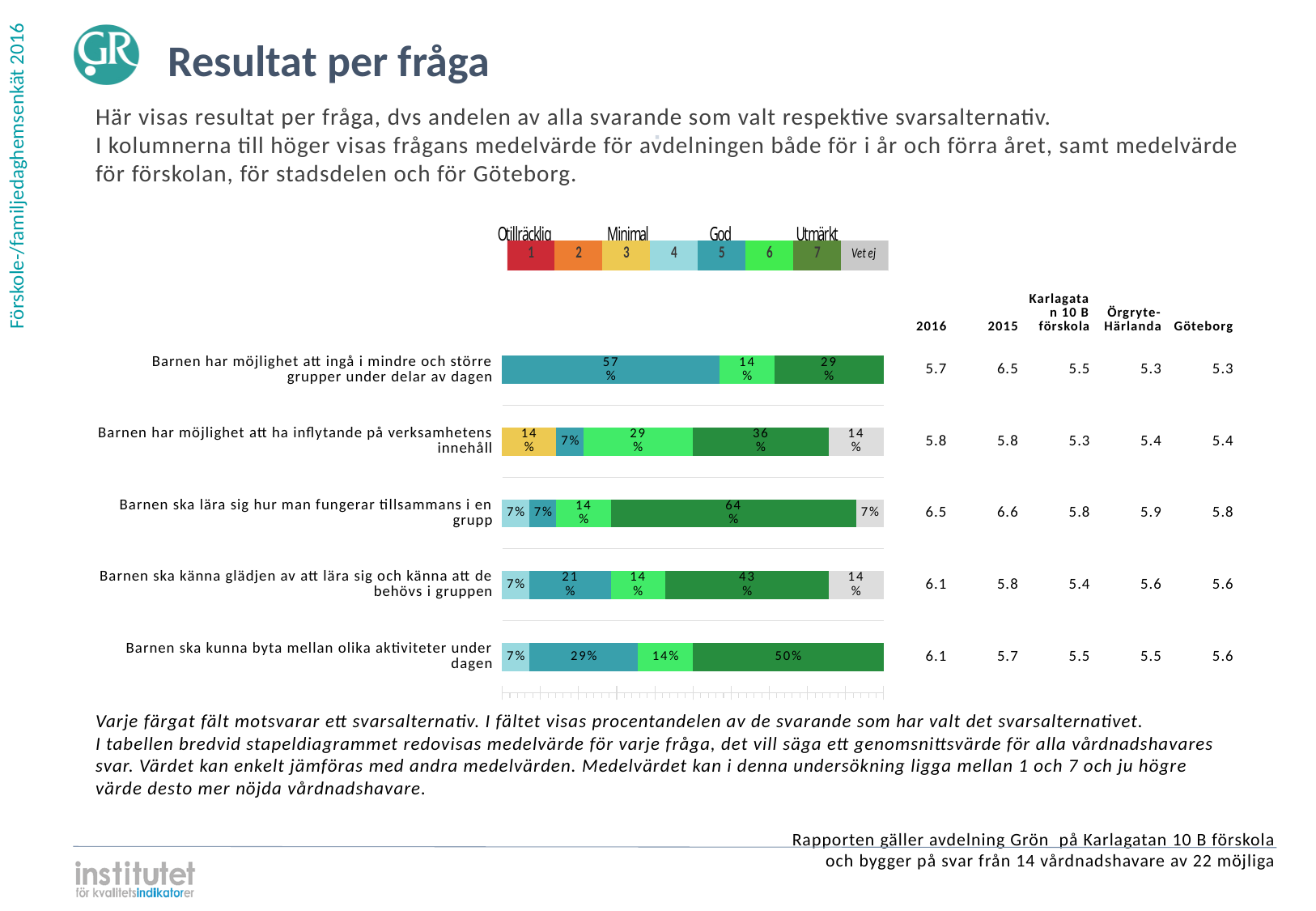
What percentage is shown for the dark green (7) segment of 'Barnen ska kunna byta mellan olika aktiviteter under dagen'? 50% How many answer options does the legend above the chart list? 8 What is the combined share of the 6 and 7 segments for 'Barnen har möjlighet att ha inflytande på verksamhetens innehåll'? 65% How many questions (categories) are plotted in the bar chart? 5 What label does the legend give to rating 7? Utmärkt What percentage is shown for the teal (5) segment of 'Barnen har möjlighet att ingå i mindre och större grupper under delar av dagen'? 57% Which question has the largest dark green (7) segment? Barnen ska lära sig hur man fungerar tillsammans i en grupp What is the difference between the dark green (7) segment for 'Barnen ska lära sig hur man fungerar tillsammans i en grupp' (64%) and for 'Barnen ska känna glädjen av att lära sig och känna att de behövs i gruppen' (43%)? 21 percentage points What percentage of respondents answered 'Vet ej' for 'Barnen har möjlighet att ha inflytande på verksamhetens innehåll'? 14% What kind of chart is shown on the slide? Stacked bar chart What percentage of respondents chose the highest rating (7, dark green) for 'Barnen ska lära sig hur man fungerar tillsammans i en grupp'? 64% Which is larger: the teal (5) segment for 'Barnen ska kunna byta mellan olika aktiviteter under dagen' or the teal (5) segment for 'Barnen ska känna glädjen av att lära sig och känna att de behövs i gruppen'? Barnen ska kunna byta mellan olika aktiviteter under dagen (29%)